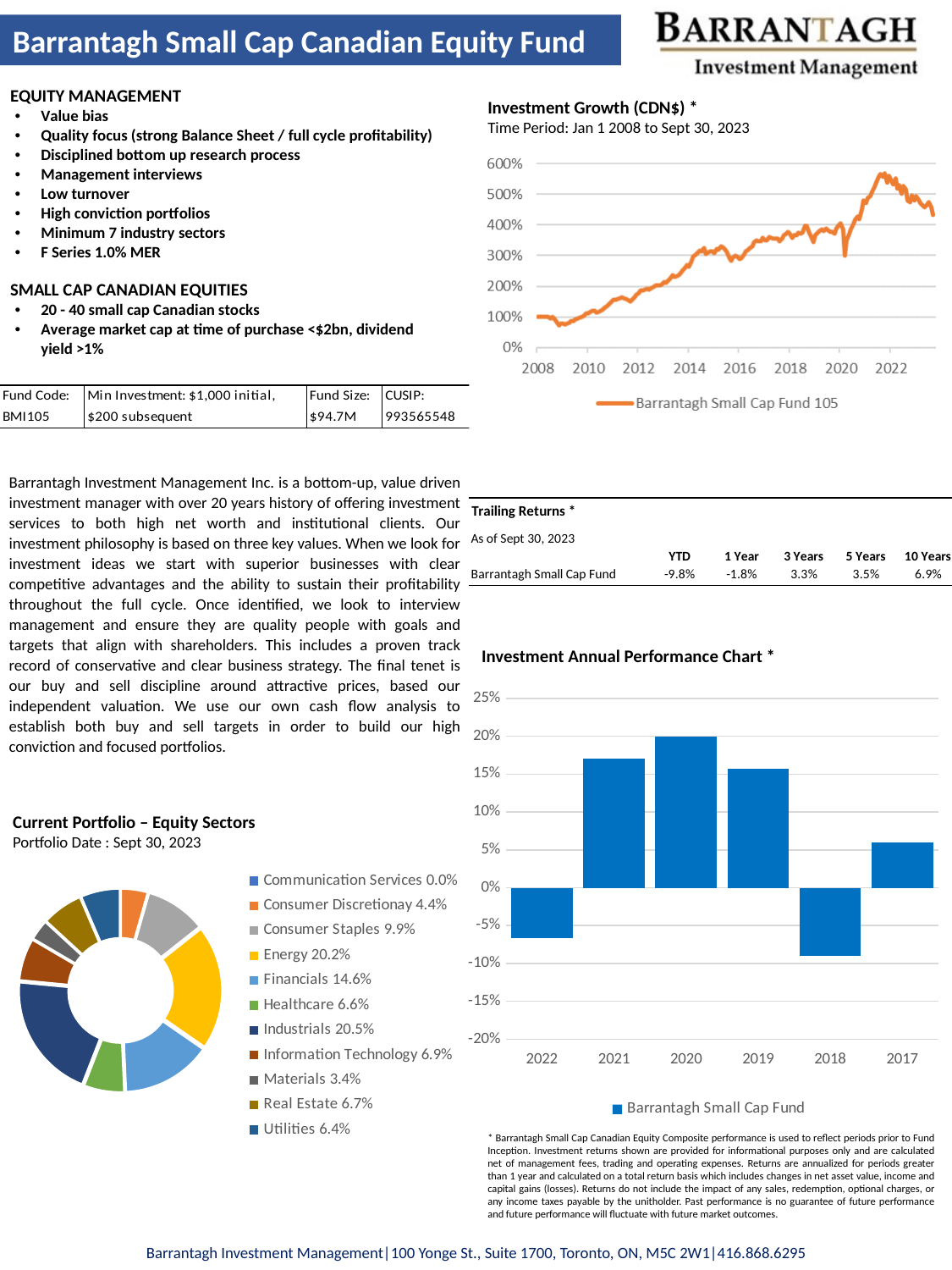
In the Investment Annual Performance Chart, which year has the lowest return? 2018 In the Investment Annual Performance Chart, how many years are shown on the x axis? 6 What kind of chart is the Investment Growth (CDN$) chart? line chart In the Current Portfolio – Equity Sectors chart, what share does Energy have? 20.2% In the Current Portfolio – Equity Sectors chart, what share does Financials have? 14.6% In the Investment Annual Performance Chart, which year has the highest return? 2020 In the Current Portfolio – Equity Sectors chart, which sector has the smallest share? Communication Services In the Current Portfolio – Equity Sectors chart, what is the difference between the Consumer Staples share and the Materials share? 6.5% In the Investment Annual Performance Chart, is the value for 2021 greater or less than 15%? greater In the Investment Growth (CDN$) chart, does the value generally rise or fall from 2008 to 2022? rise In the Current Portfolio – Equity Sectors chart, how many sectors are listed in the legend? 11 In the Current Portfolio – Equity Sectors chart, which sector has the largest share? Industrials